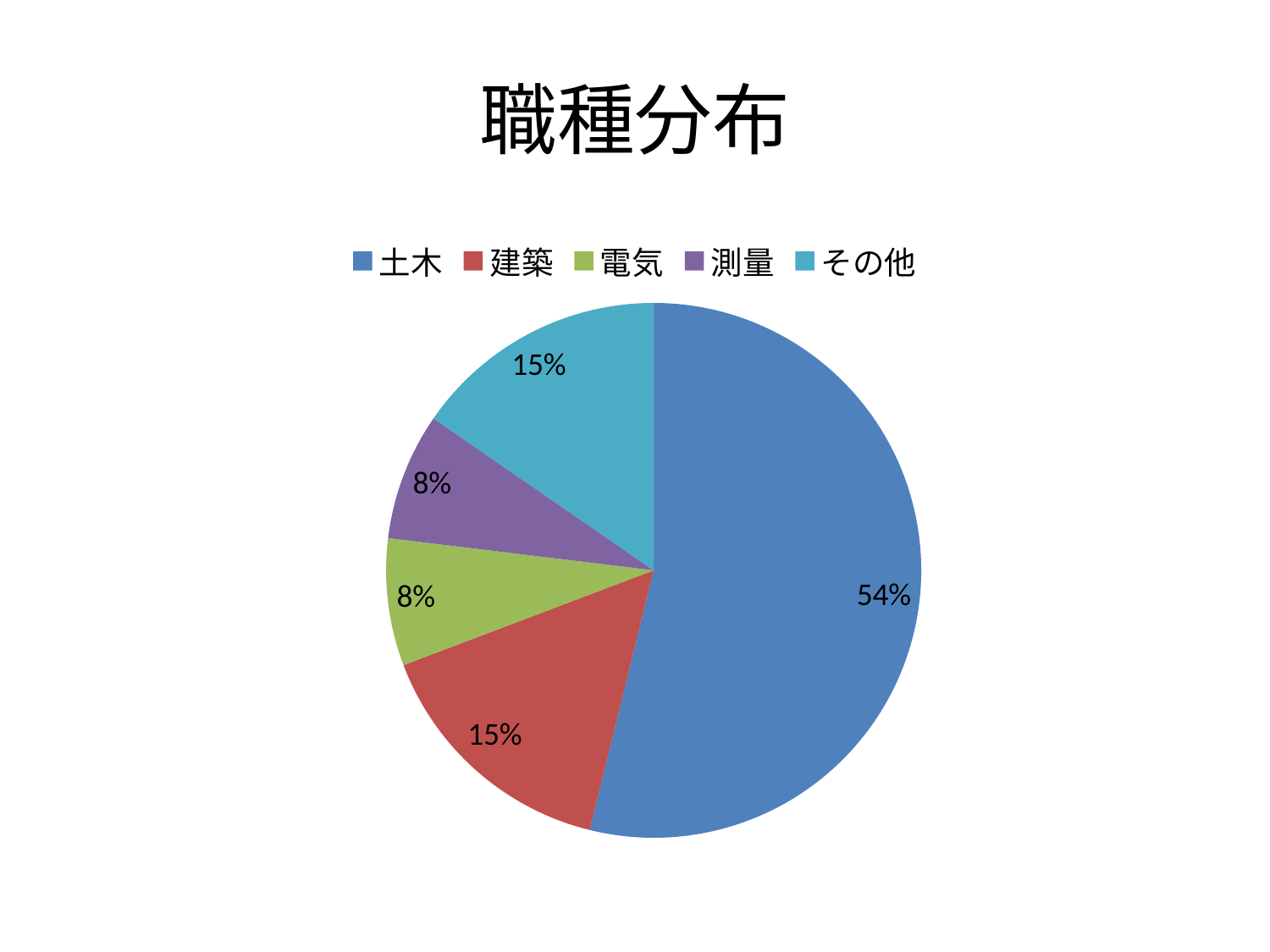
Which category has the largest slice of the pie? 土木 What is the difference in percentage points between 土木 and 建築? 39 What colour is the slice for 電気? green What share of the pie does 土木 represent? 54% What share of the pie does その他 represent? 15% How many categories does the pie chart show? 5 How many entries does the legend list? 5 What is the title of the chart? 職種分布 What share of the pie does 電気 represent? 8% What kind of chart is shown on the slide? pie chart Which is larger, the slice for 建築 or the slice for 測量? 建築